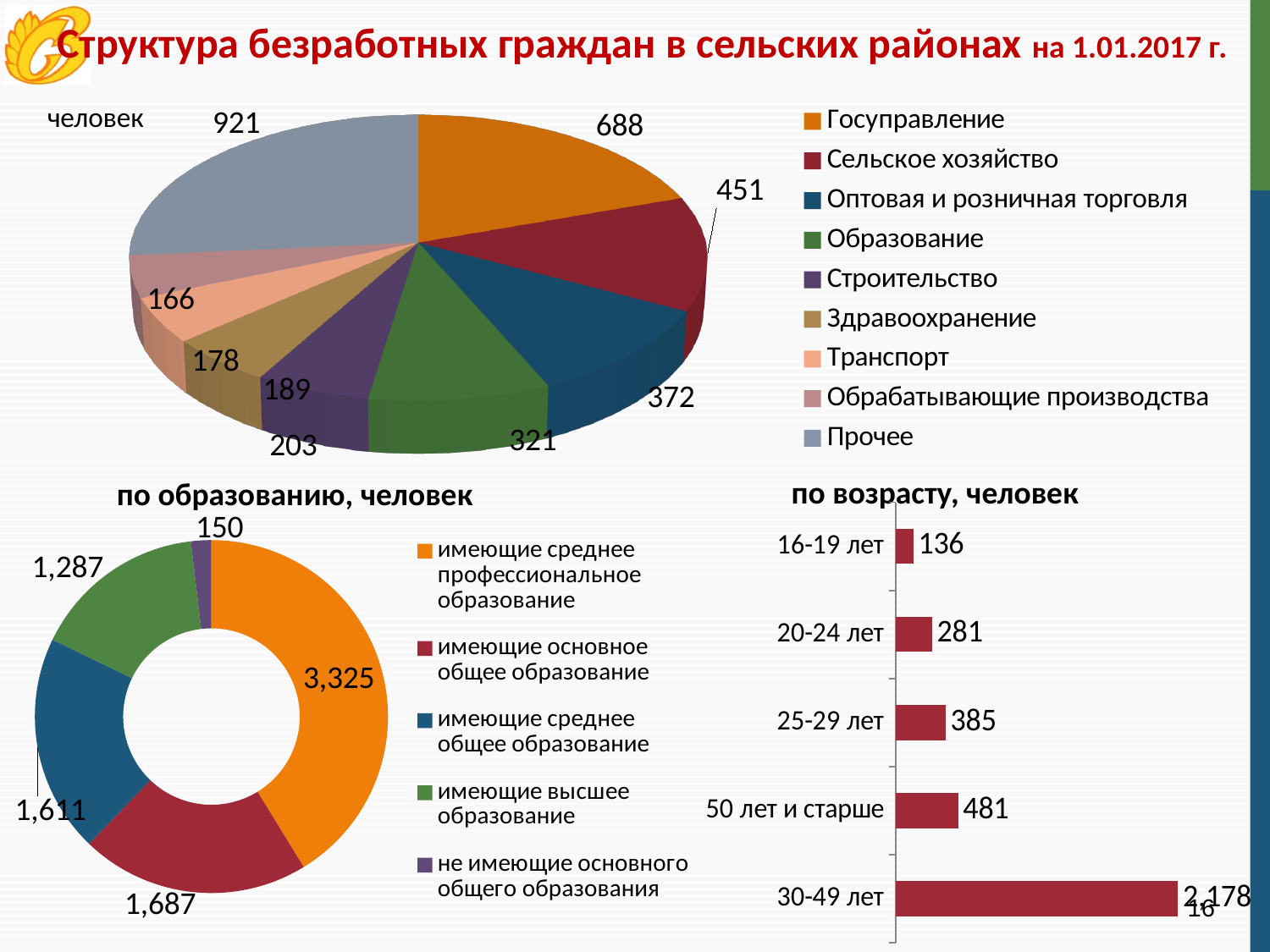
In the bottom-left chart 'по образованию, человек', what is the value for имеющие высшее образование? 1,287 What kind of chart is the bottom-left chart 'по образованию, человек'? doughnut chart In the top pie chart, which category has the smallest value? Обрабатывающие производства In the bottom-right chart 'по возрасту, человек', what is the difference between 50 лет и старше and 16-19 лет? 345 In the bottom-right chart 'по возрасту, человек', what is the value for 30-49 лет? 2,178 What kind of chart is the bottom-right chart 'по возрасту, человек'? bar chart In the top pie chart, what is the difference between Сельское хозяйство and Образование? 130 In the bottom-left chart 'по образованию, человек', which is larger: имеющие основное общее образование or имеющие среднее общее образование? имеющие основное общее образование In the top pie chart, how many categories does the legend list? 9 In the top pie chart, how many unemployed people are in the Госуправление category? 688 In the bottom-left chart 'по образованию, человек', which category has the largest value? имеющие среднее профессиональное образование In the top pie chart, which category has the largest value? Прочее